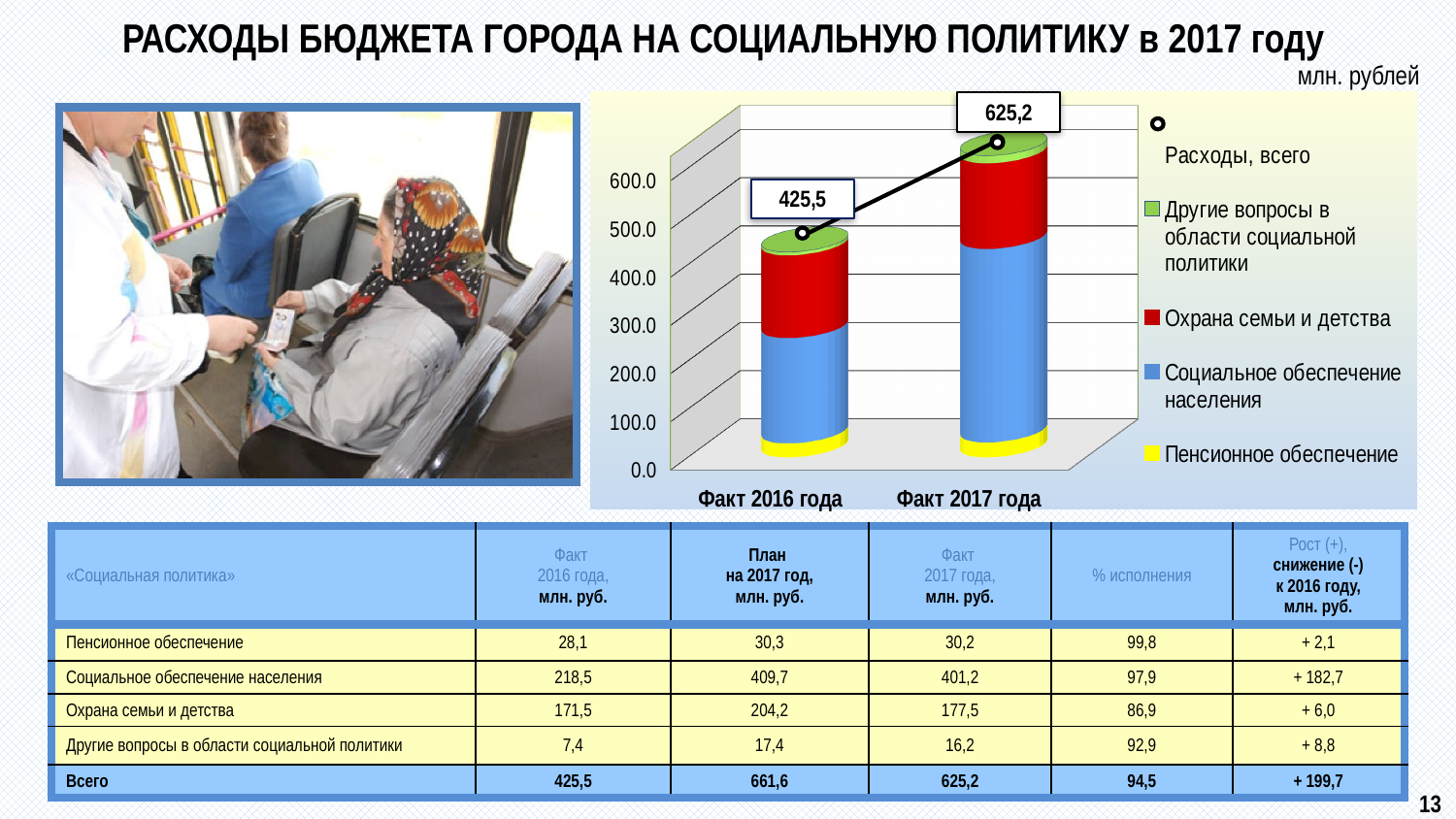
Which category has the higher total expenditure, Факт 2016 года or Факт 2017 года? Факт 2017 года What is the total expenditure value labelled for Факт 2016 года? 425,5 How many categories are shown on the x axis of the chart? 2 Which category has the lowest total expenditure? Факт 2016 года What is the difference between the total for Факт 2017 года and the total for Факт 2016 года? 199,7 Is the total for Факт 2016 года greater or less than 400.0? greater Is the total for Факт 2017 года greater or less than 600.0? greater Do the total expenditures rise or fall from Факт 2016 года to Факт 2017 года? rise Which legend entry is shown in red? Охрана семьи и детства How many entries does the chart legend list? 5 What is the total expenditure value labelled for Факт 2017 года? 625,2 What type of chart is shown on the slide? Bar chart (stacked)